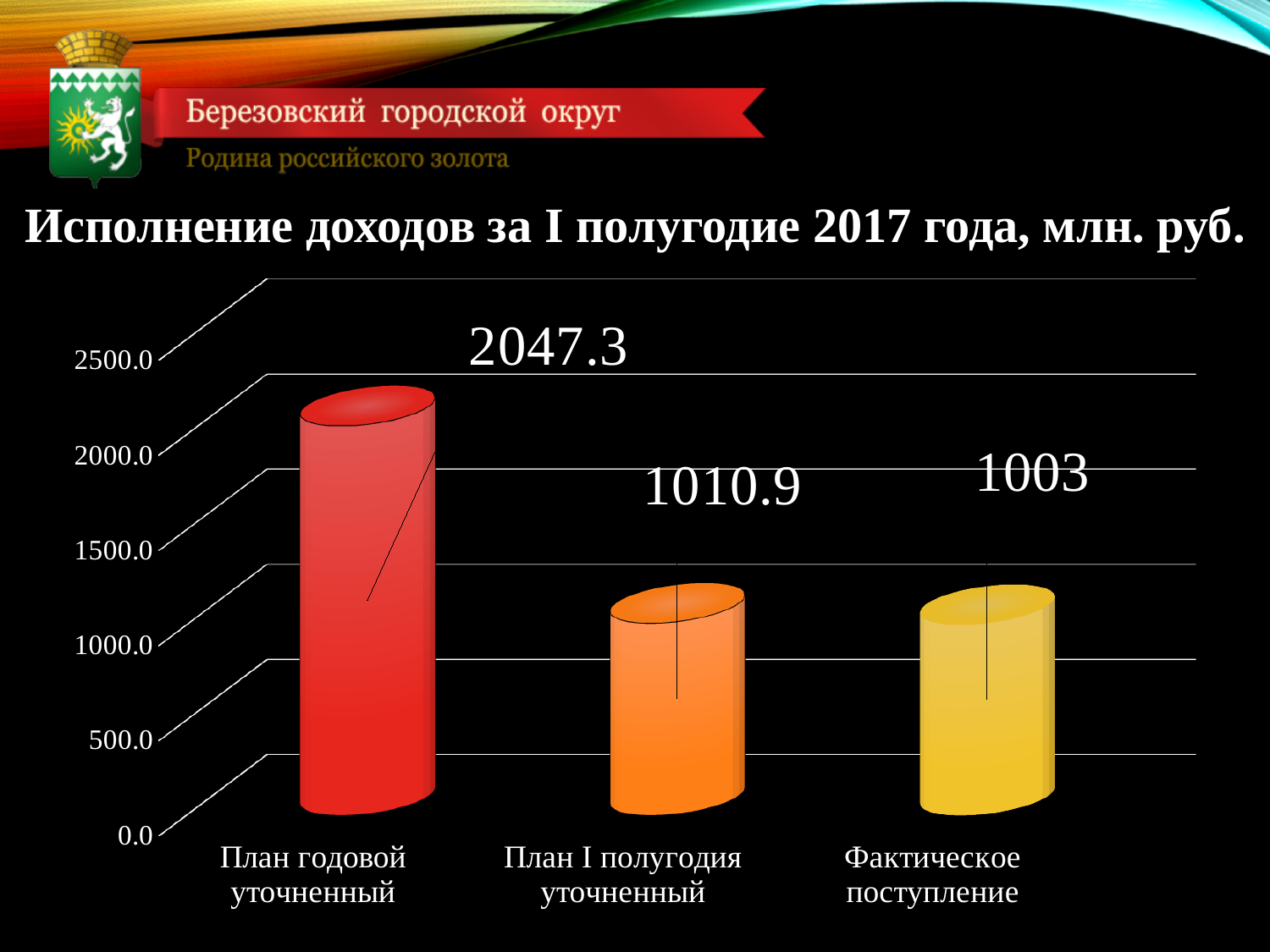
What is the difference between "План годовой уточненный" and "План I полугодия уточненный"? 1036.4 What is the value for "План годовой уточненный"? 2047.3 Which is larger, "План I полугодия уточненный" or "Фактическое поступление"? План I полугодия уточненный Which category has the highest value? План годовой уточненный What is the value for "План I полугодия уточненный"? 1010.9 What is the value for "Фактическое поступление"? 1003 Is the value for "Фактическое поступление" greater or less than 1500? less What is the difference between "План I полугодия уточненный" and "Фактическое поступление"? 7.9 Which category has the lowest value? Фактическое поступление What is the title of the chart? Исполнение доходов за I полугодие 2017 года, млн. руб. How many categories are shown in the chart? 3 What type of chart is shown on the slide? bar chart